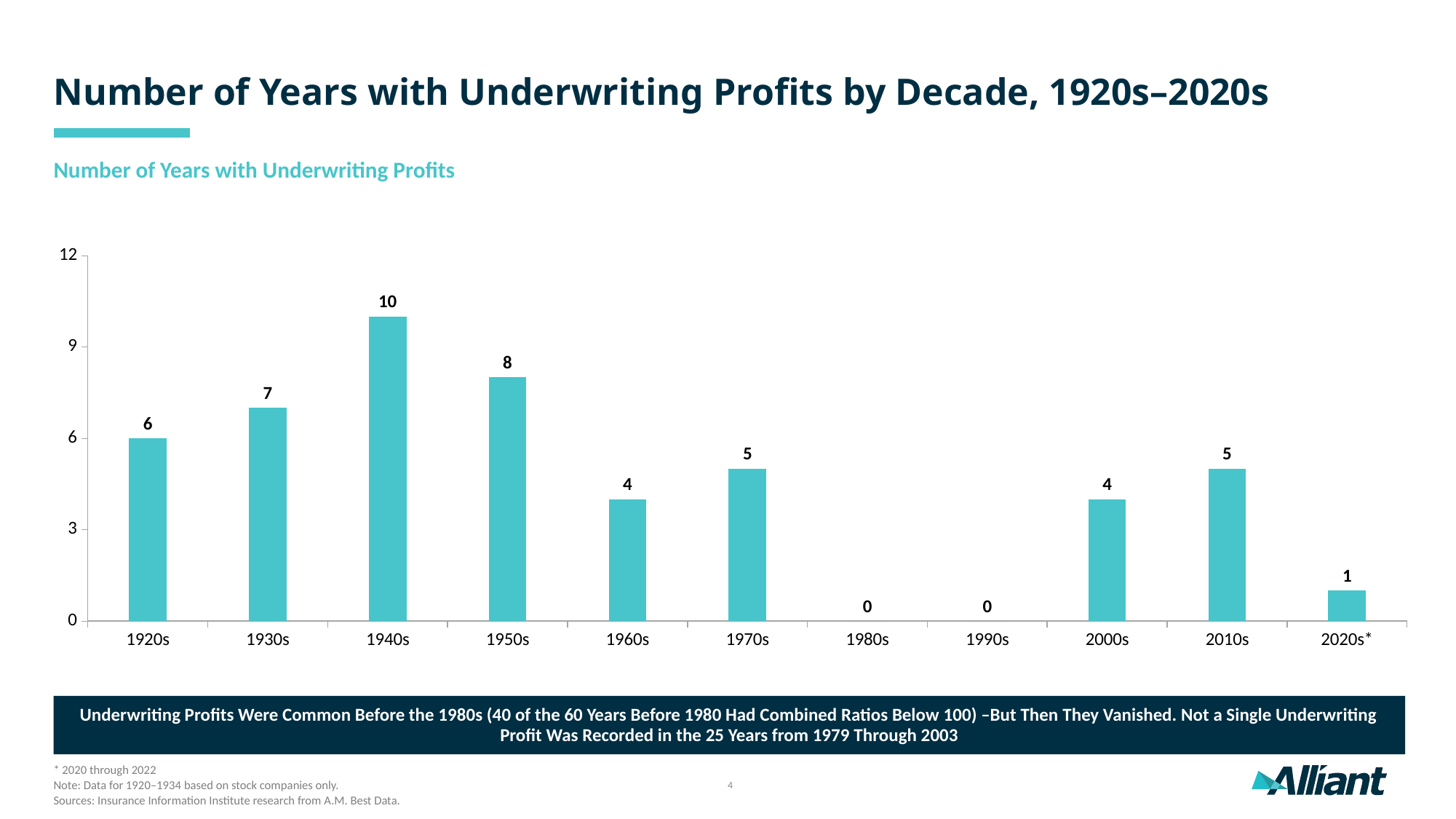
How many decades are shown on the x axis? 11 What kind of chart is shown on the slide? Bar chart What is the title of the chart? Number of Years with Underwriting Profits How many years with underwriting profits are shown for the 1940s? 10 Do the values rise or fall from the 1940s to the 1960s? Fall What is the difference between the values for the 1940s and the 1950s? 2 Is the value for the 1950s greater or less than 6? greater What is the value for the 1970s? 5 What is the value for the 2020s*? 1 Which decades show a value of 0? 1980s and 1990s Which decade has the highest number of years with underwriting profits? 1940s Which is larger, the value for the 1930s or the value for the 2010s? 1930s